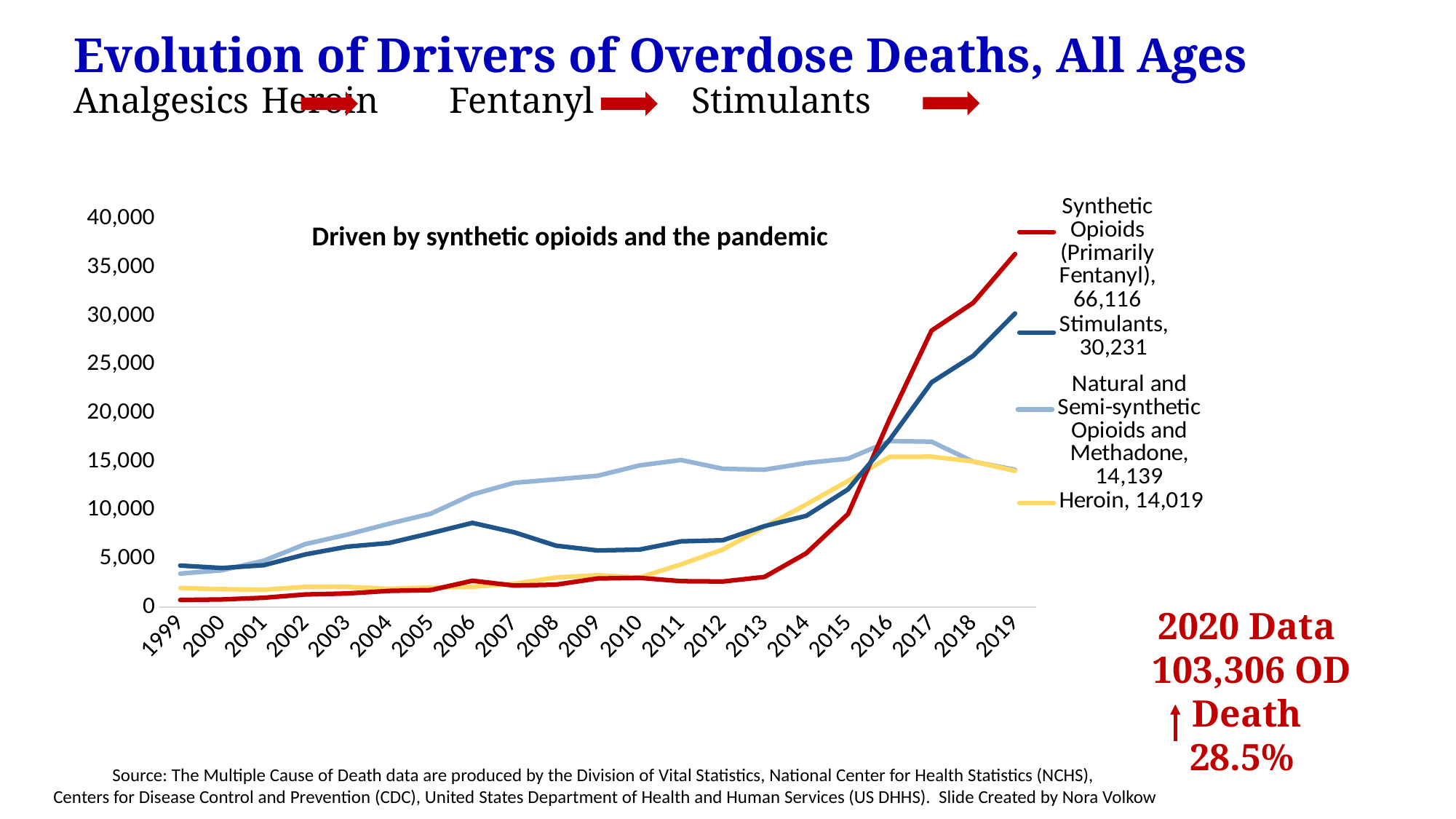
What value is printed next to Heroin in the chart's legend? 14,019 Which series has the lowest value in 2000? Synthetic Opioids (Primarily Fentanyl) What kind of chart is shown on the slide? line chart Is the value for Heroin in 2010 greater or less than 5,000? less How many series does the chart's legend list? 4 In 2019, which is higher: Synthetic Opioids (Primarily Fentanyl) or Stimulants? Synthetic Opioids (Primarily Fentanyl) Is the value for Natural and Semi-synthetic Opioids and Methadone in 2011 greater or less than 10,000? greater Do the values for Stimulants rise or fall from 2013 to 2019? rise Is the value for Stimulants in 2019 greater or less than 25,000? greater How many years are shown along the x axis of the chart? 21 In 2010, which is higher: Natural and Semi-synthetic Opioids and Methadone or Stimulants? Natural and Semi-synthetic Opioids and Methadone